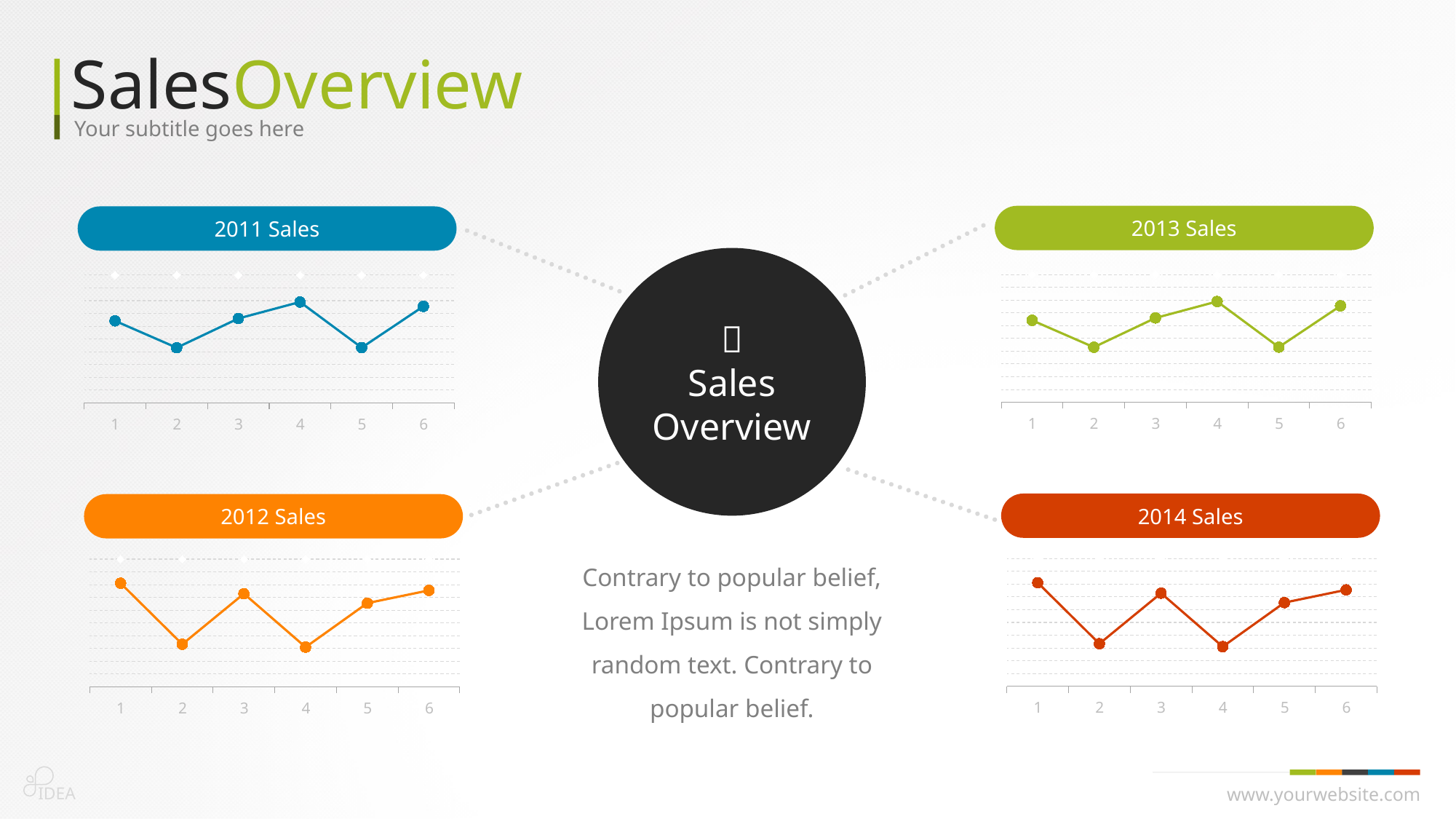
How many line charts are shown on the slide? 4 In the 2013 Sales chart, do the values rise or fall from category 2 to category 4? rise How many data points are plotted in the 2013 Sales chart? 6 In the 2014 Sales chart, which is larger, the value at category 3 or at category 4? category 3 In the 2012 Sales chart, which is larger, the value at category 1 or at category 2? category 1 What colour is the line in the 2012 Sales chart? orange What kind of chart is the 2011 Sales chart? line chart In the 2012 Sales chart, do the values rise or fall from category 4 to category 6? rise In the 2014 Sales chart, do the values rise or fall from category 1 to category 2? fall In the 2013 Sales chart, which category has the highest value? 4 In the 2011 Sales chart, which is larger, the value at category 4 or at category 5? category 4 In the 2011 Sales chart, which category has the highest value? 4